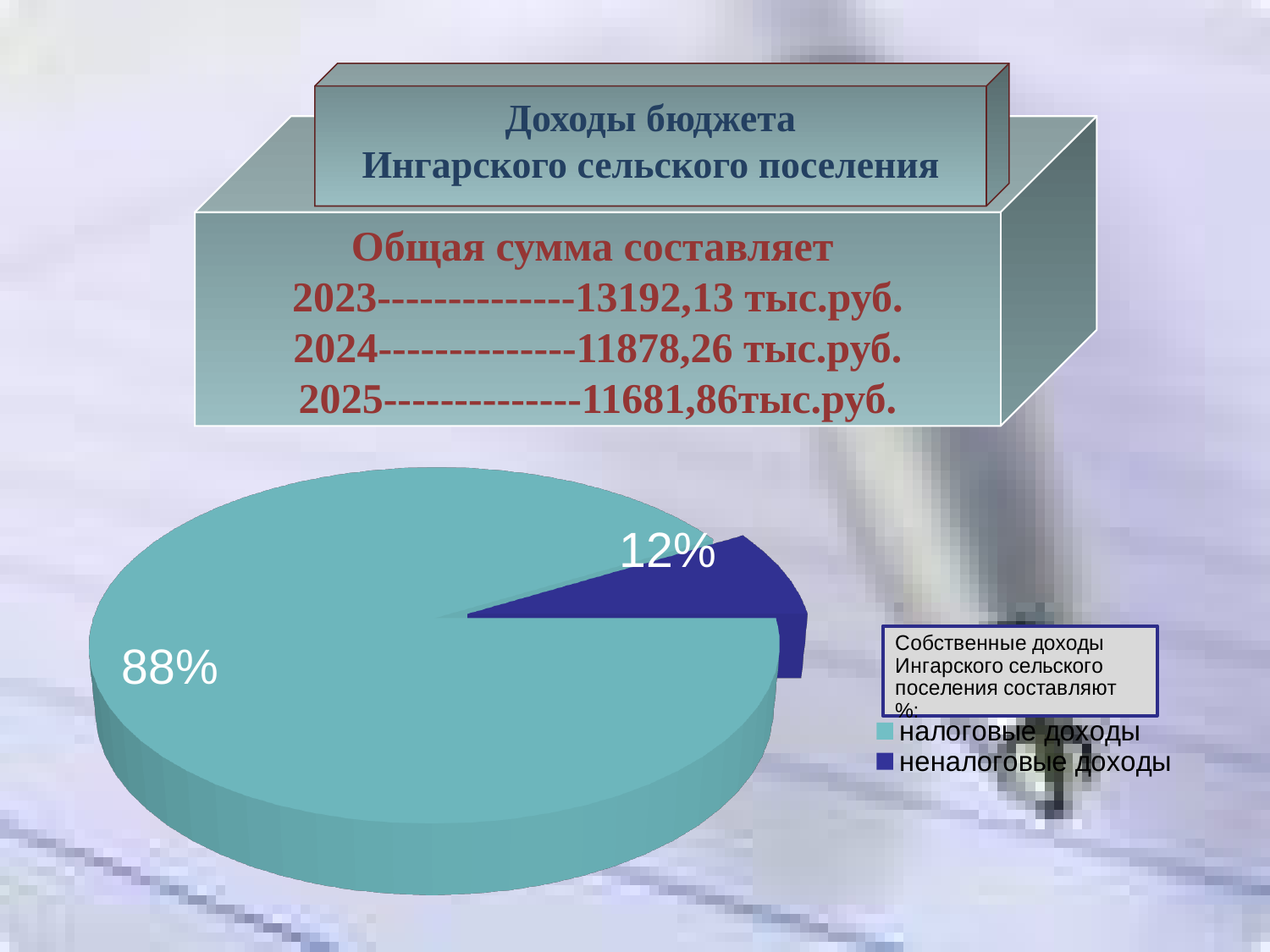
What is the total of the two percentages shown on the pie chart? 100% What is the difference in percentage points between налоговые доходы and неналоговые доходы? 76 Which legend entry is shown in light teal? налоговые доходы What share of the pie does неналоговые доходы take? 12% What kind of chart is shown on the slide? pie chart Which slice of the pie is the smallest? неналоговые доходы What colour is the slice for неналоговые доходы? dark blue Which slice of the pie is the largest? налоговые доходы How many entries does the legend list? 2 What share of the pie does налоговые доходы take? 88% How many slices does the pie chart have? 2 Which is larger, the share for налоговые доходы or the share for неналоговые доходы? налоговые доходы